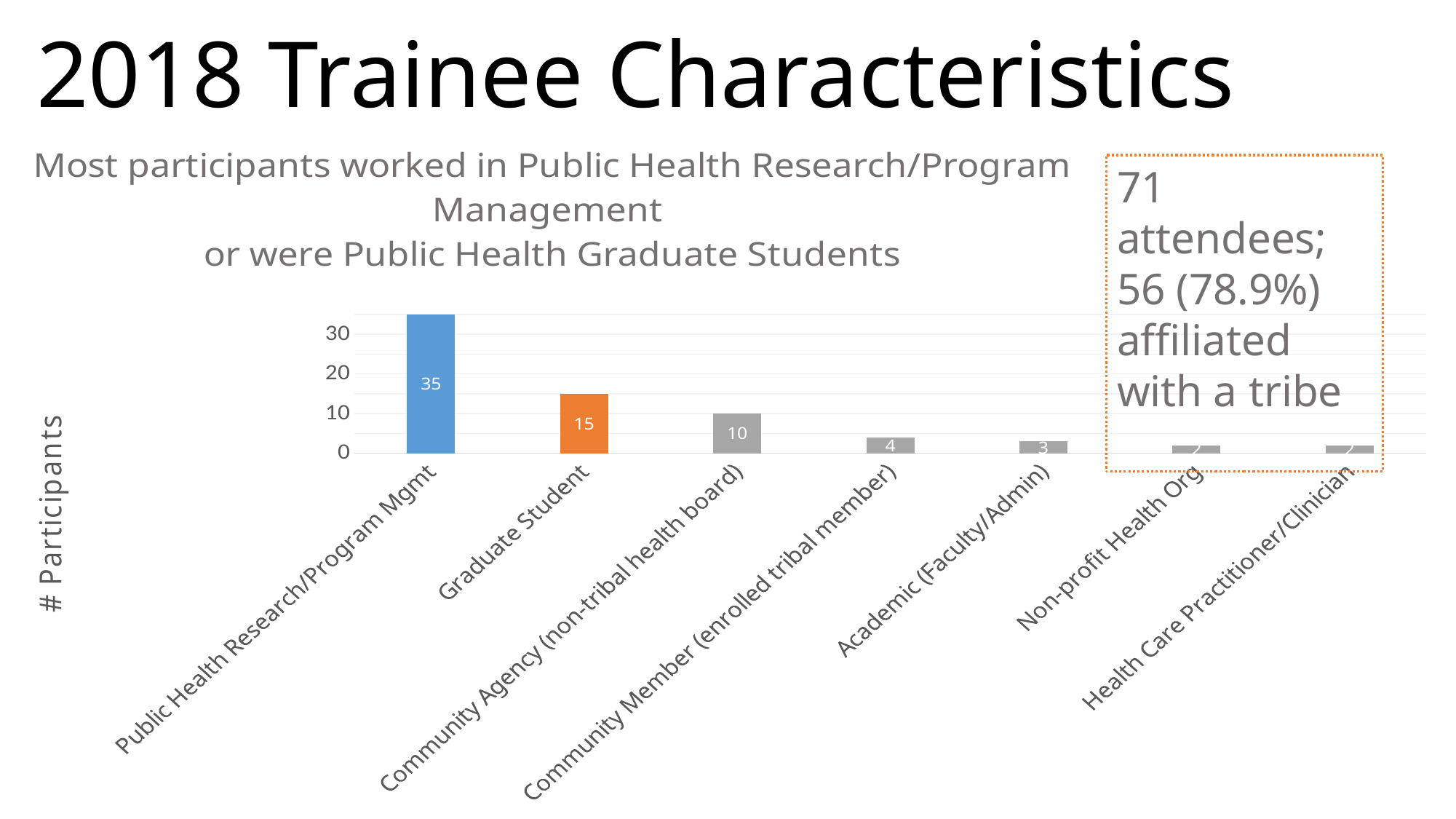
What is the value for Academic (Faculty/Admin)? 3 What is the value for Graduate Student? 15 What is the value for Community Member (enrolled tribal member)? 4 What is the difference between the values for Public Health Research/Program Mgmt and Graduate Student? 20 Which category has the highest number of participants? Public Health Research/Program Mgmt What is the value for Public Health Research/Program Mgmt? 35 What is the value for Community Agency (non-tribal health board)? 10 Is the value for Non-profit Health Org greater or less than 10? less What kind of chart is shown on the slide? bar chart What is the label of the vertical axis? # Participants How many categories are shown on the x axis? 7 Which is larger, the value for Graduate Student or the value for Community Agency (non-tribal health board)? Graduate Student